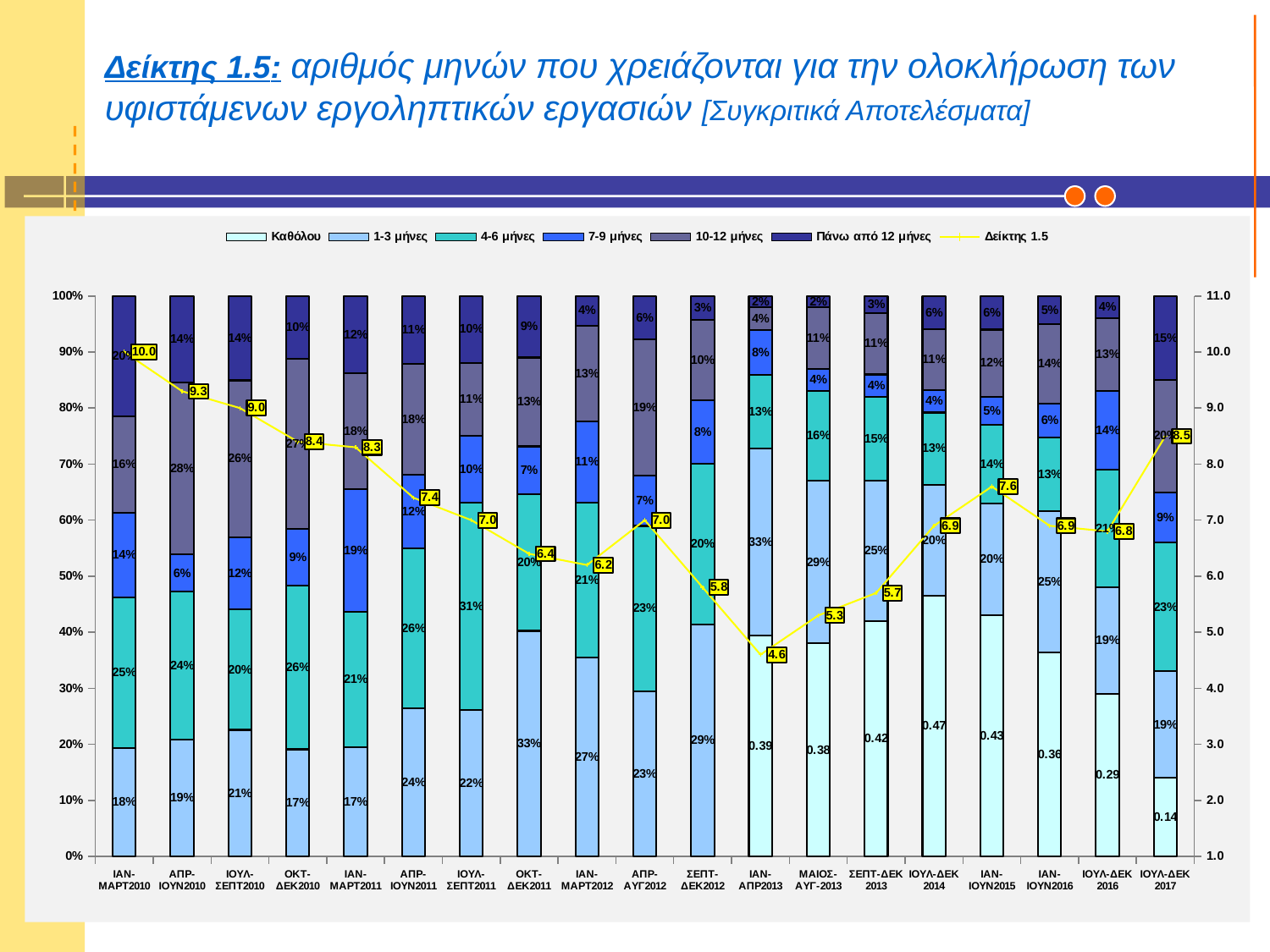
In which period is Δείκτης 1.5 lowest? ΙΑΝ-ΑΠΡ2013 What is the value of Δείκτης 1.5 for ΙΟΥΛ-ΔΕΚ 2017? 8.5 Which is larger, Δείκτης 1.5 for ΙΑΝ-ΙΟΥΝ2015 or for ΙΟΥΛ-ΔΕΚ 2016? ΙΑΝ-ΙΟΥΝ2015 How many series does the legend list? 7 In which period is Δείκτης 1.5 highest? ΙΑΝ-ΜΑΡΤ2010 What type of chart is shown on the slide? stacked bar chart with a line What is the difference between Δείκτης 1.5 for ΙΑΝ-ΜΑΡΤ2010 and for ΙΑΝ-ΑΠΡ2013? 5.4 What is the value of Δείκτης 1.5 for ΙΑΝ-ΜΑΡΤ2010? 10.0 How many time periods (categories) are shown on the x axis? 19 What is the Καθόλου value labelled for ΙΟΥΛ-ΔΕΚ 2014? 0.47 What is the Πάνω από 12 μήνες share for ΙΟΥΛ-ΔΕΚ 2017? 15%